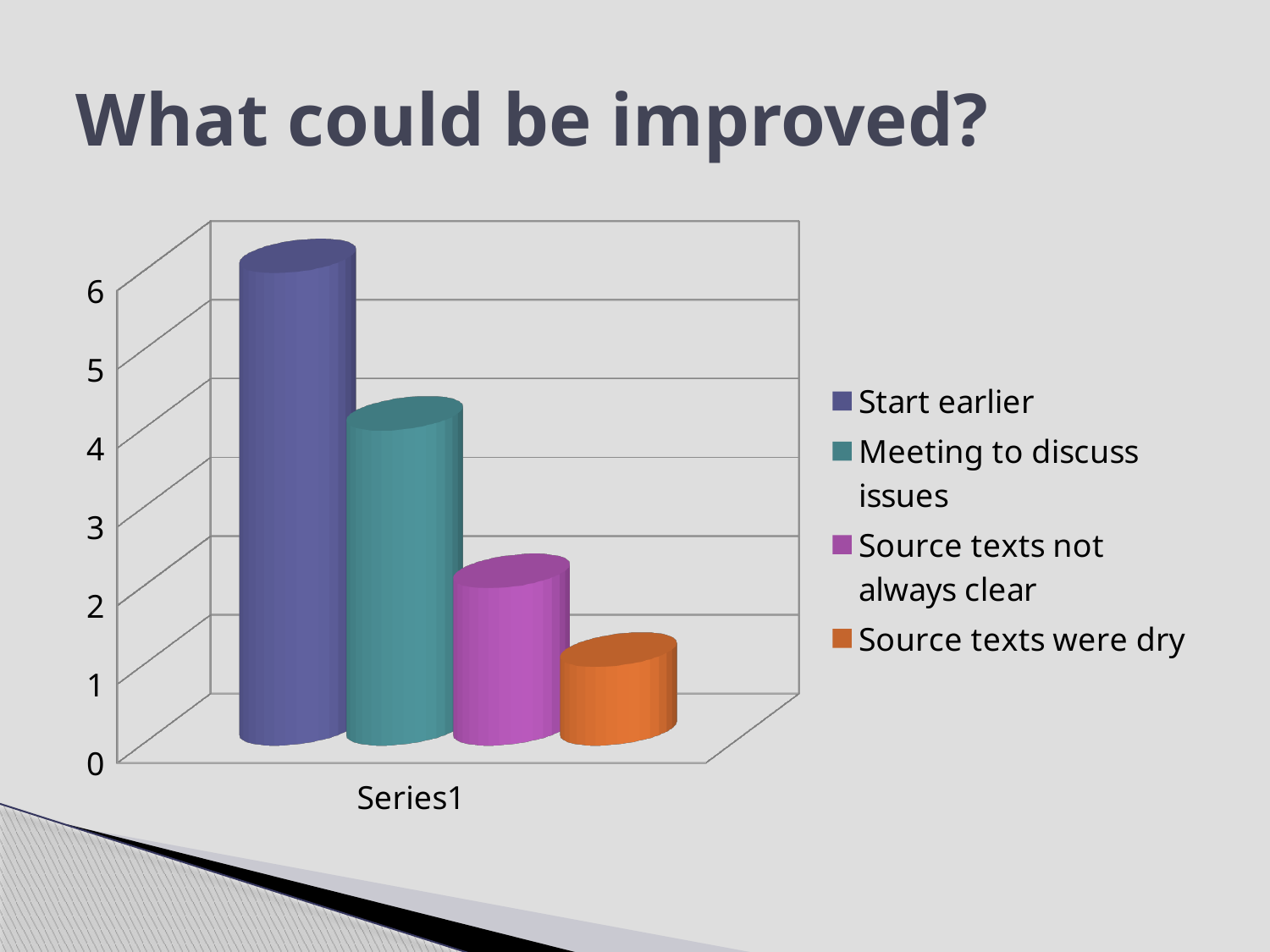
Which bar is taller: Source texts were dry or Start earlier? Start earlier Is the value for Meeting to discuss issues greater or less than 3? greater Which bar is taller: Meeting to discuss issues or Source texts not always clear? Meeting to discuss issues Is the value for Start earlier greater or less than 5? greater How many entries does the chart's legend list? 4 Which legend entry has the shortest bar? Source texts were dry How many bars are plotted in the chart? 4 Which legend entry has the tallest bar? Start earlier Is the value for Source texts were dry greater or less than 2? less What kind of chart is shown on the slide? bar chart What is the title of the slide containing the chart? What could be improved?